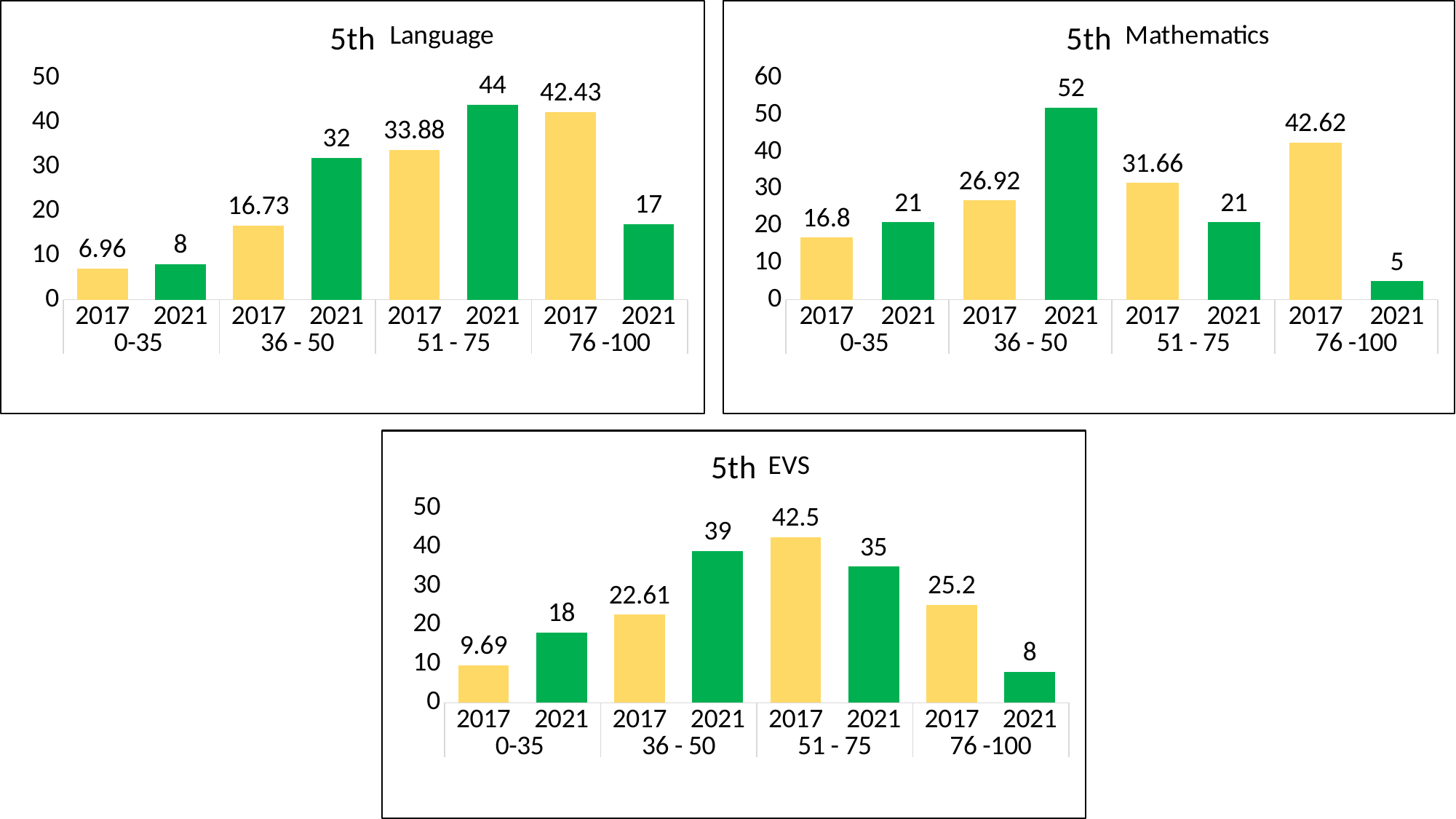
In the '5th Mathematics' chart, which bar has the highest value? 2021 in the 36 - 50 band In the '5th Language' chart, what is the value for 2017 in the 0-35 band? 6.96 What type of chart is the '5th EVS' chart? Bar chart In the '5th EVS' chart, which bar has the lowest value? 2021 in the 76 -100 band In the '5th Mathematics' chart, what is the value for 2021 in the 76 -100 band? 5 In the '5th Mathematics' chart, what is the difference between the 2017 and 2021 values in the 0-35 band? 4.2 In the '5th Language' chart, what is the value for 2021 in the 51 - 75 band? 44 How many charts are shown on the slide? 3 In the '5th EVS' chart, which is larger: the 2017 value or the 2021 value in the 36 - 50 band? 2021 In the '5th EVS' chart, what is the value for 2017 in the 51 - 75 band? 42.5 In the '5th Language' chart, what is the difference between the 2017 and 2021 values in the 76 -100 band? 25.43 How many bars are plotted in the '5th Mathematics' chart? 8